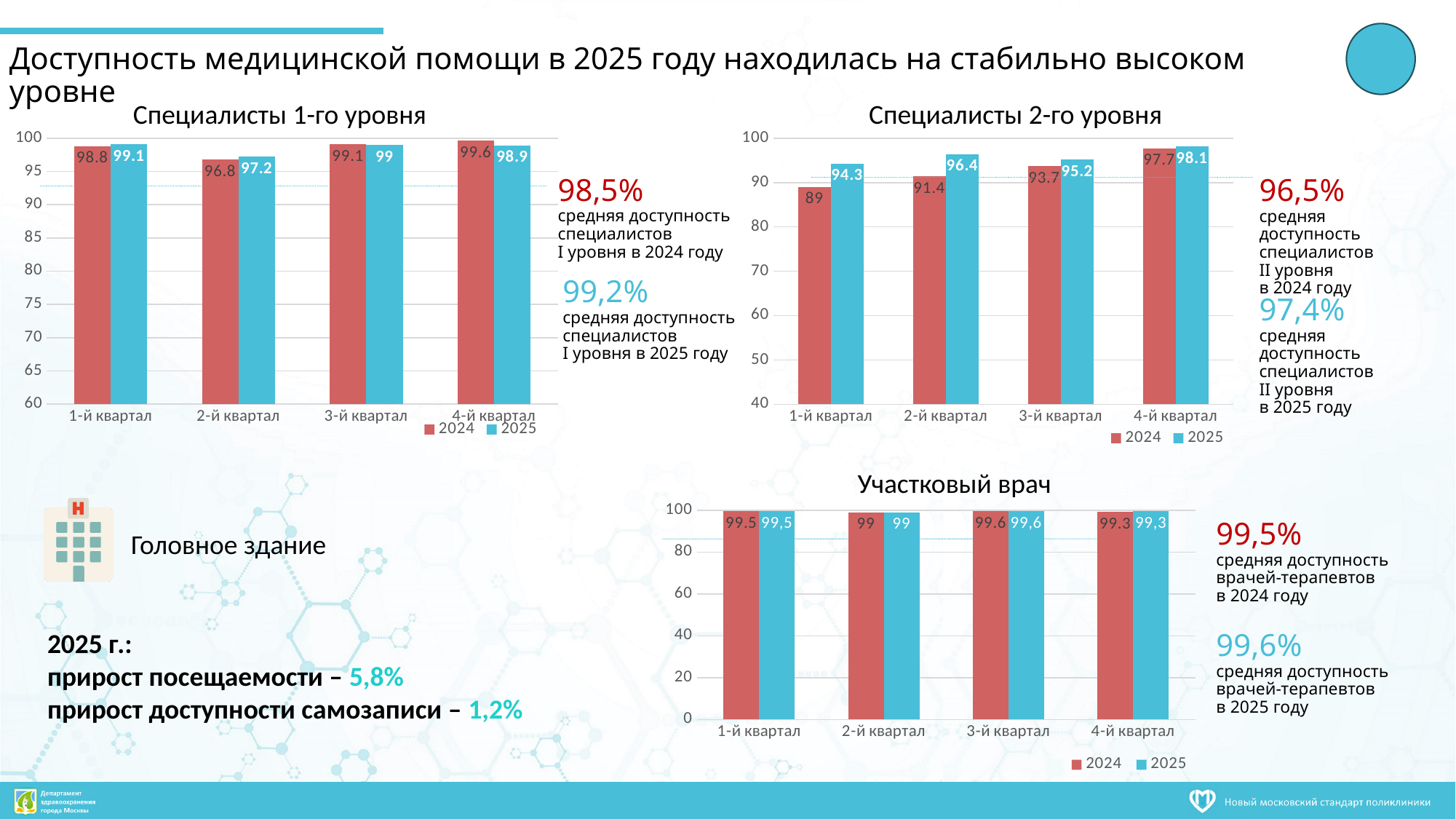
In the chart 'Специалисты 2-го уровня', what is the value for 2025 in 2-й квартал? 96.4 What type of chart is 'Специалисты 1-го уровня'? bar chart In the chart 'Специалисты 1-го уровня', what is the difference between the 2025 and 2024 values in 2-й квартал? 0.4 How many series does the legend of the chart 'Участковый врач' list? 2 In the chart 'Специалисты 1-го уровня', which quarter has the highest 2024 value? 4-й квартал In the chart 'Специалисты 2-го уровня', do the 2024 values rise or fall from 1-й квартал to 4-й квартал? rise In the chart 'Участковый врач', what is the value for 2024 in 3-й квартал? 99.6 In the chart 'Специалисты 1-го уровня', what is the value for 2024 in 2-й квартал? 96.8 In the chart 'Специалисты 2-го уровня', what is the difference between the 2025 and 2024 values in 1-й квартал? 5.3 In the chart 'Специалисты 2-го уровня', which quarter has the lowest 2024 value? 1-й квартал In the chart 'Специалисты 2-го уровня', is the 2024 value in 1-й квартал larger or smaller than the 2025 value in 1-й квартал? smaller In the chart 'Участковый врач', how many quarters are shown on the x axis? 4